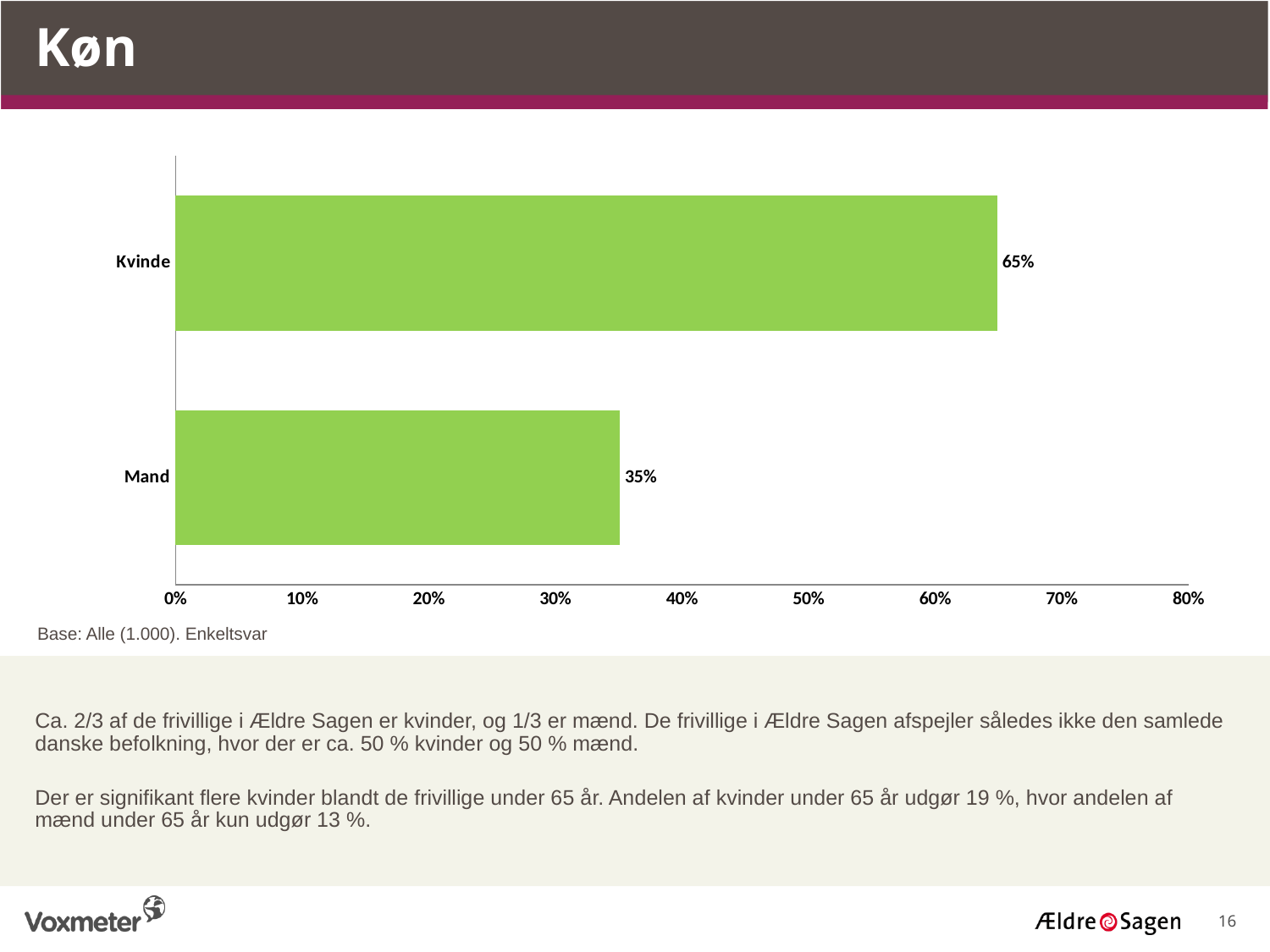
What kind of chart is shown on the slide? bar chart What is the value for Mand? 35% Which is larger, the value for Kvinde or the value for Mand? Kvinde How many categories are shown in the chart? 2 What is the difference between the values for Kvinde and Mand? 30% Is the value for Mand greater or less than 40%? less What is the value for Kvinde? 65% Which category has the highest value? Kvinde Is the value for Kvinde greater or less than 60%? greater Which category has the lowest value? Mand What is the highest value shown on the x axis of the chart? 80% What is the title of the slide containing the chart? Køn